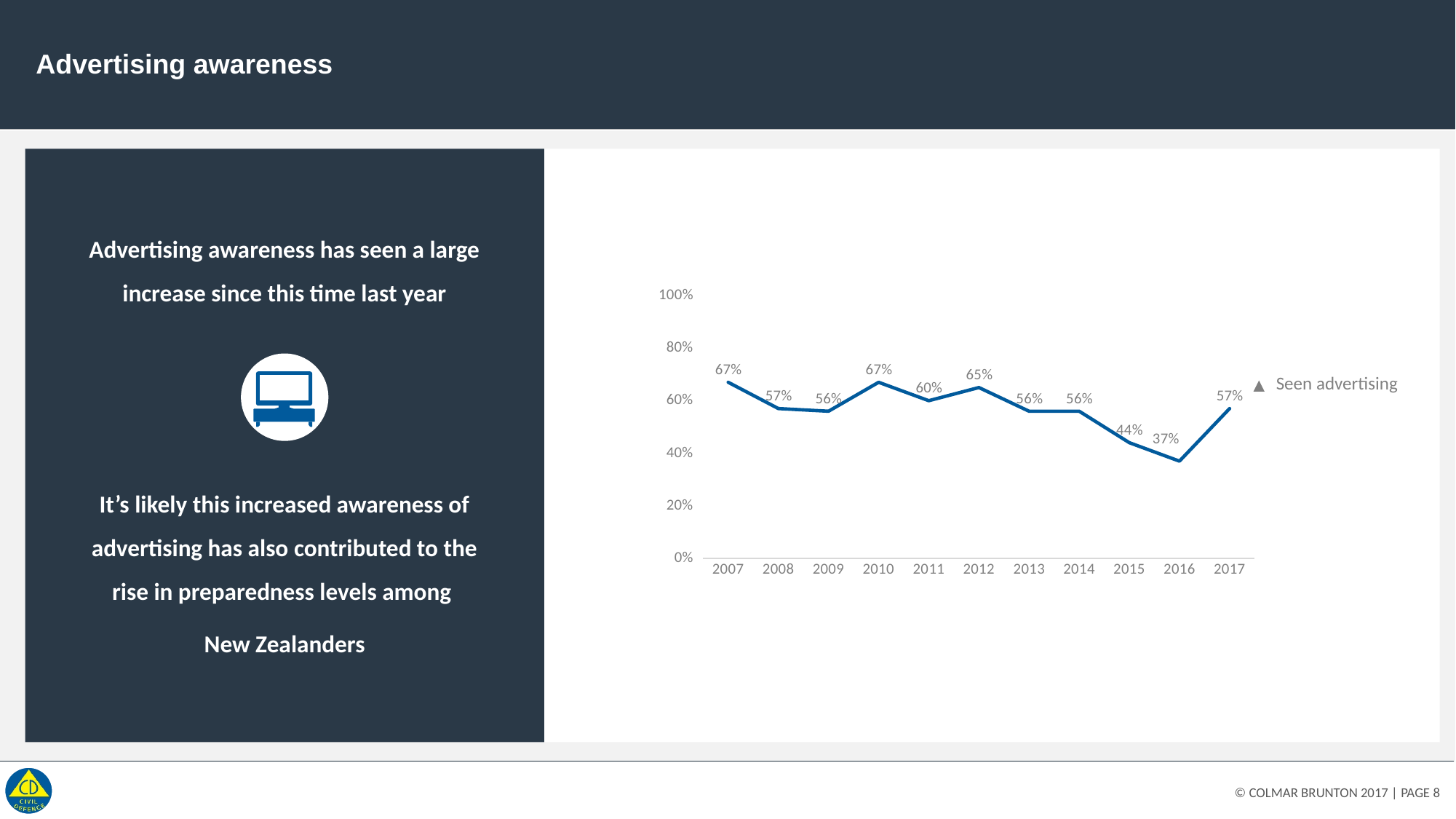
What is the difference between the Seen advertising values for 2007 and 2015? 23% What percentage had seen advertising in 2017? 57% What is the difference between the Seen advertising values for 2017 and 2016? 20% How many years are plotted on the chart? 11 Did the Seen advertising value rise or fall from 2016 to 2017? rise How many series does the legend list? 1 What percentage had seen advertising in 2016? 37% What percentage had seen advertising in 2012? 65% What kind of chart is shown on the slide? line chart Is the value for 2015 greater or less than 60%? less Which year has the lowest value for Seen advertising? 2016 Which is larger, the Seen advertising value for 2010 or for 2011? 2010